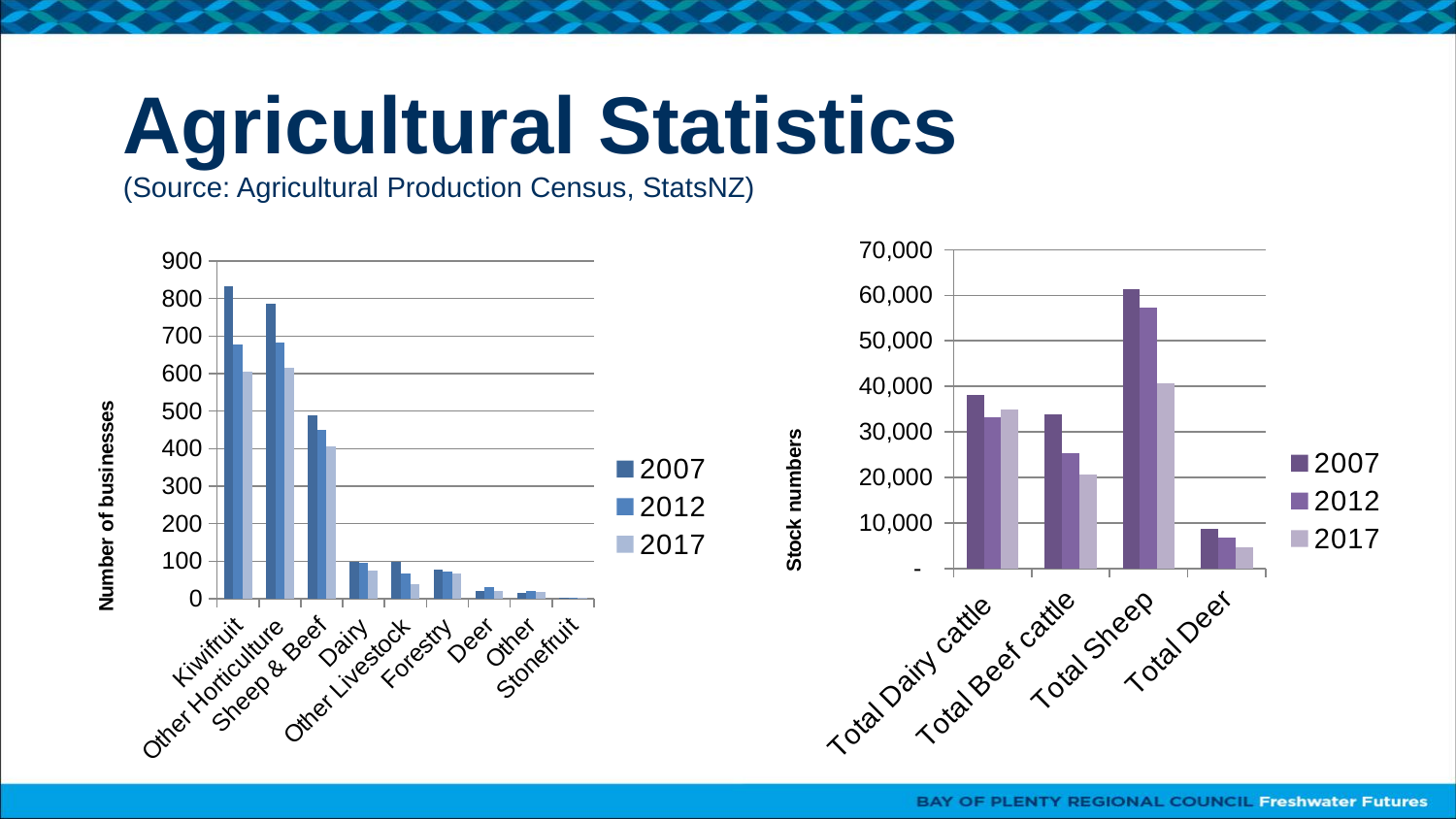
On the right chart (Stock numbers), is the 2007 value for Total Sheep greater or less than 60,000? greater On the left chart (Number of businesses), do the Kiwifruit values rise or fall from 2007 to 2017? fall What kind of chart is the right chart (Stock numbers)? bar chart On the left chart (Number of businesses), is the 2012 value for Other Horticulture greater or less than 600? greater On the left chart (Number of businesses), is the 2007 value for Kiwifruit greater or less than 800? greater On the left chart (Number of businesses), which category has the lowest number of businesses? Stonefruit On the left chart (Number of businesses), which category has the highest number of businesses in 2007? Kiwifruit On the right chart (Stock numbers), how many series does the legend list? 3 On the left chart (Number of businesses), how many categories are shown on the x axis? 9 On the right chart (Stock numbers), which category has the highest stock numbers? Total Sheep On the right chart (Stock numbers), which category has the lowest stock numbers? Total Deer